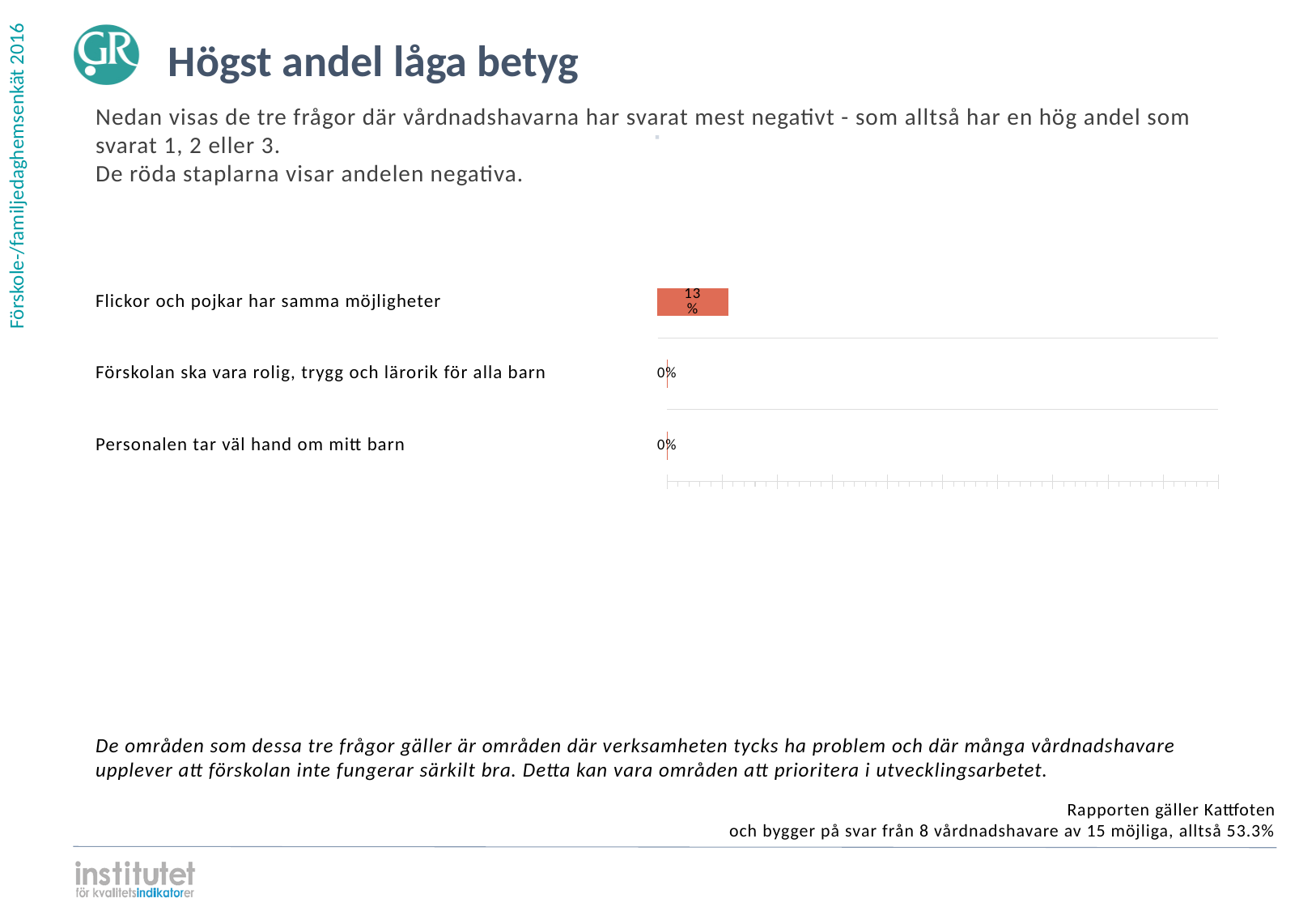
What is the value for "Flickor och pojkar har samma möjligheter"? 13% What is the title of the slide containing the chart? Högst andel låga betyg What is the difference between the value for "Flickor och pojkar har samma möjligheter" and the value for "Personalen tar väl hand om mitt barn"? 13% How many categories have a value of 0%? 2 What is the value for "Personalen tar väl hand om mitt barn"? 0% Which is larger: the value for "Flickor och pojkar har samma möjligheter" or the value for "Förskolan ska vara rolig, trygg och lärorik för alla barn"? Flickor och pojkar har samma möjligheter What is the value for "Förskolan ska vara rolig, trygg och lärorik för alla barn"? 0% What kind of chart is shown on the slide? Bar chart How many categories are shown in the chart? 3 What colour are the bars in the chart? Red Which category has the highest value? Flickor och pojkar har samma möjligheter